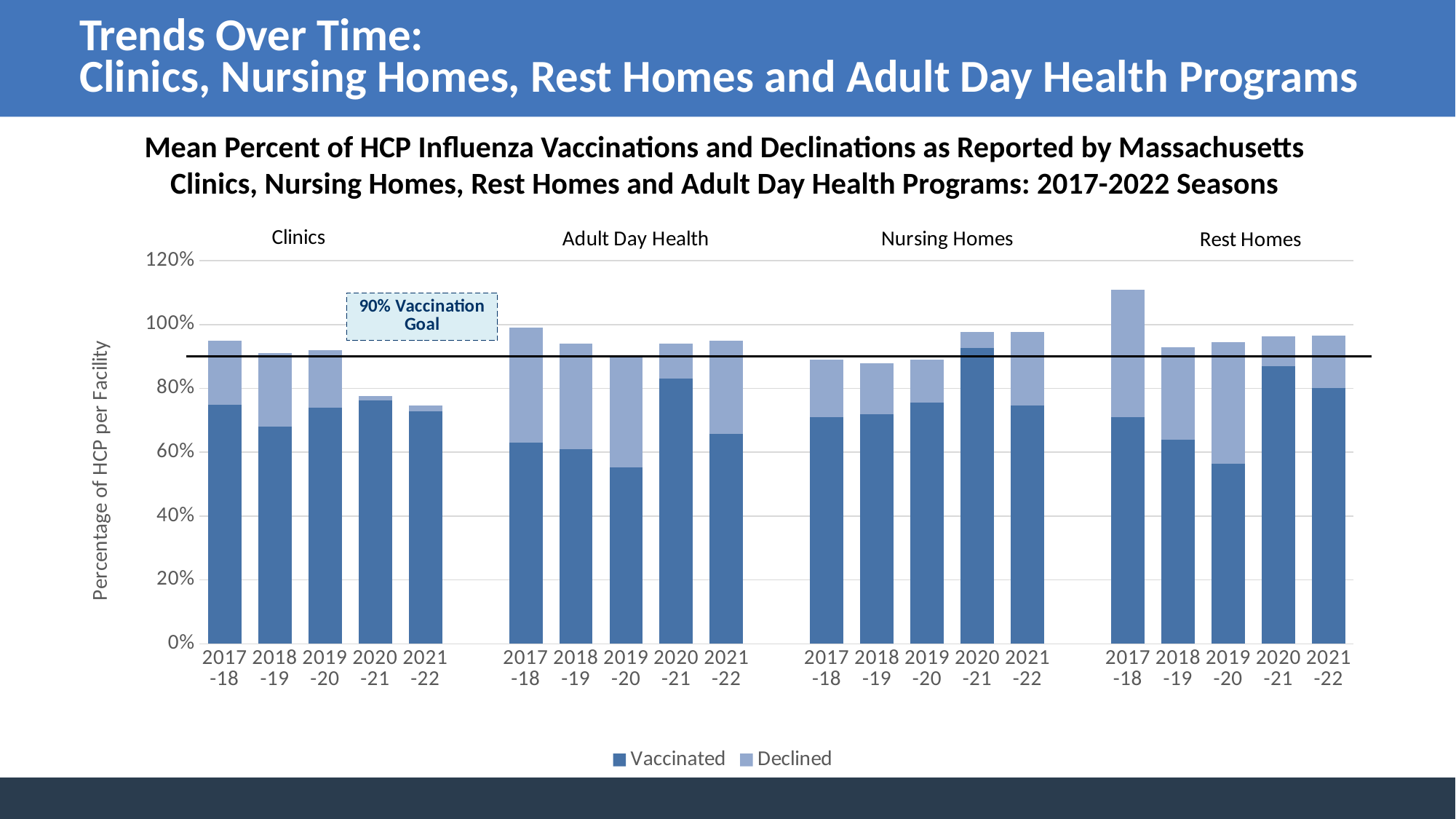
Which season has the tallest total stacked bar across the whole chart? Rest Homes 2017-18 How many facility type groups are shown along the x axis? 4 What kind of chart is shown on the slide? Stacked bar chart Within the Clinics group, which season has the highest total stacked bar? 2017-18 Do the Vaccinated values for Nursing Homes rise or fall from 2017-18 to 2020-21? rise Is the Vaccinated value for Clinics in 2017-18 greater or less than 60%? greater What vaccination goal is marked by the horizontal line on the chart? 90% Vaccination Goal Is the Vaccinated value for Adult Day Health in 2019-20 greater or less than 60%? less Which is larger, the Vaccinated value for Clinics in 2017-18 or for Adult Day Health in 2017-18? Clinics 2017-18 How many series does the legend list? 2 How many seasons are plotted for each facility type? 5 Is the total stacked bar for Rest Homes in 2017-18 greater or less than 100%? greater